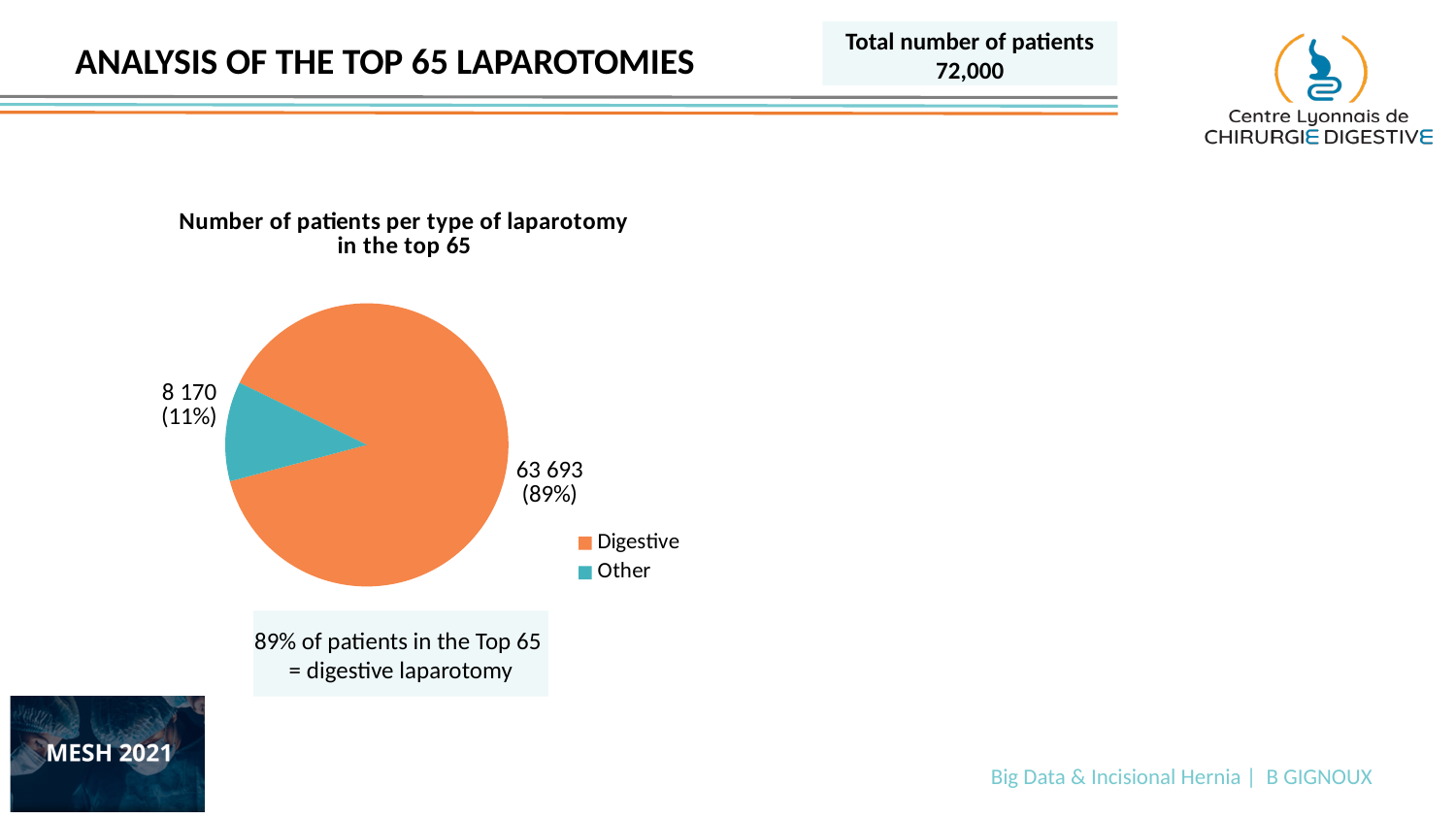
How many categories does the pie chart have? 2 What is the difference in number of patients between Digestive and Other? 55 523 What share of the pie does the Other slice represent? 11% Which colour represents the Other category in the legend? teal What is the title of the chart? Number of patients per type of laparotomy in the top 65 Which is larger, the Digestive slice or the Other slice? Digestive Which category has the smallest slice? Other How many patients are in the Digestive slice? 63 693 What kind of chart is shown on the slide? pie chart How many patients are in the Other slice? 8 170 What share of the pie does the Digestive slice represent? 89% Which category has the largest slice? Digestive